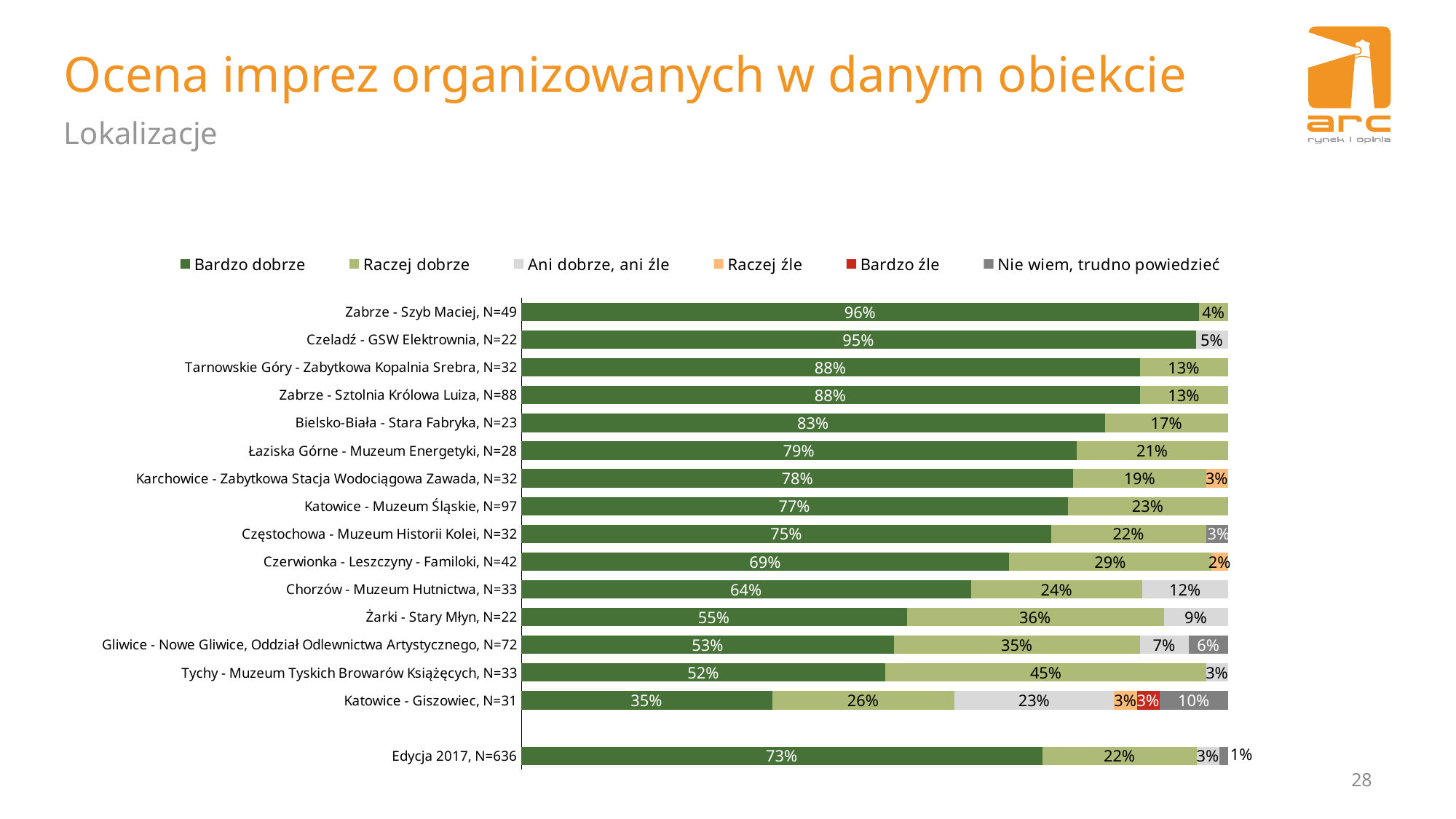
What is the "Raczej dobrze" value for Tychy - Muzeum Tyskich Browarów Książęcych, N=33? 45% What is the "Ani dobrze, ani źle" value for Chorzów - Muzeum Hutnictwa, N=33? 12% What is the "Bardzo dobrze" value for Edycja 2017, N=636? 73% What is the "Bardzo dobrze" value for Zabrze - Szyb Maciej, N=49? 96% Which location has the highest "Bardzo dobrze" value? Zabrze - Szyb Maciej, N=49 How many series does the legend list? 6 What is the difference between the "Bardzo dobrze" values for Bielsko-Biała - Stara Fabryka, N=23 and Łaziska Górne - Muzeum Energetyki, N=28? 4 percentage points Which has a larger "Raczej dobrze" value: Żarki - Stary Młyn, N=22 or Gliwice - Nowe Gliwice, Oddział Odlewnictwa Artystycznego, N=72? Żarki - Stary Młyn, N=22 What kind of chart is shown on the slide? Stacked bar chart Which location has the lowest "Bardzo dobrze" value? Katowice - Giszowiec, N=31 How many bars are plotted in the chart, including Edycja 2017? 16 What is the "Nie wiem, trudno powiedzieć" value for Katowice - Giszowiec, N=31? 10%